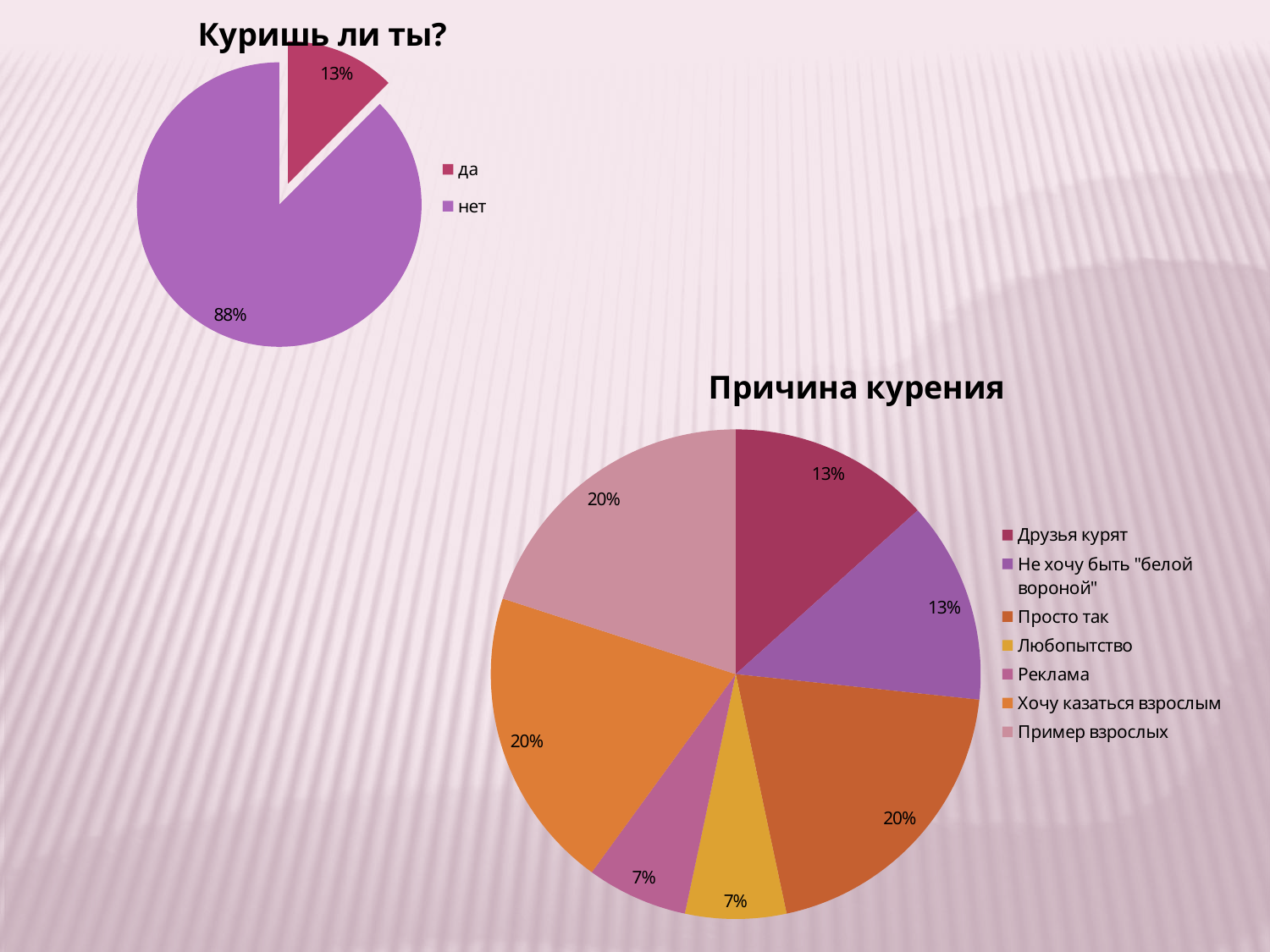
In the chart titled "Куришь ли ты?", what kind of chart is shown? pie chart In the chart titled "Причина курения", what is the share for "Друзья курят"? 13% In the chart titled "Куришь ли ты?", how many entries does the legend list? 2 In the chart titled "Причина курения", which legend entry is shown in yellow? Любопытство In the chart titled "Причина курения", what is the share for "Просто так"? 20% In the chart titled "Причина курения", how many categories does the legend list? 7 In the chart titled "Причина курения", what is the share for "Любопытство"? 7% In the chart titled "Причина курения", which is larger: "Хочу казаться взрослым" or "Реклама"? Хочу казаться взрослым In the chart titled "Куришь ли ты?", what percentage answered "да"? 13% In the chart titled "Куришь ли ты?", what percentage answered "нет"? 88% In the chart titled "Куришь ли ты?", which answer has the largest share? нет In the chart titled "Причина курения", what is the difference between the shares for "Пример взрослых" and "Реклама"? 13%